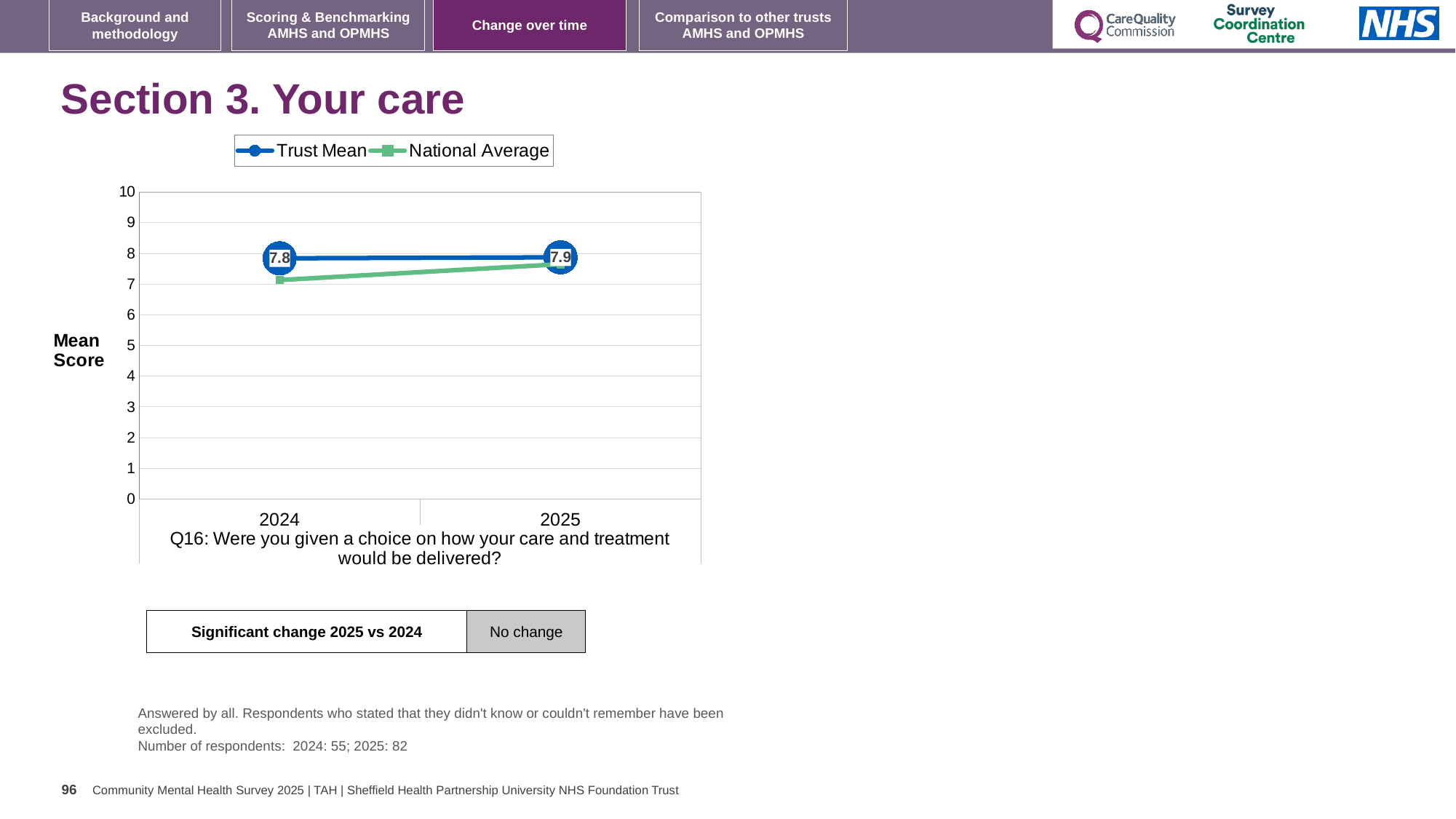
Is the National Average value for 2025 greater or less than 7? greater How many series does the legend list? 2 What is the label on the y axis of the chart? Mean Score In 2024, which series is higher, Trust Mean or National Average? Trust Mean What is the Trust Mean score for 2025? 7.9 How many years are plotted on the x axis? 2 What kind of chart is shown on the slide? Line chart Which year has the higher Trust Mean score, 2024 or 2025? 2025 By how much did the Trust Mean change from 2024 to 2025? 0.1 Is the National Average value for 2024 greater or less than 8? less Does the Trust Mean rise or fall from 2024 to 2025? Rise What is the Trust Mean score for 2024? 7.8